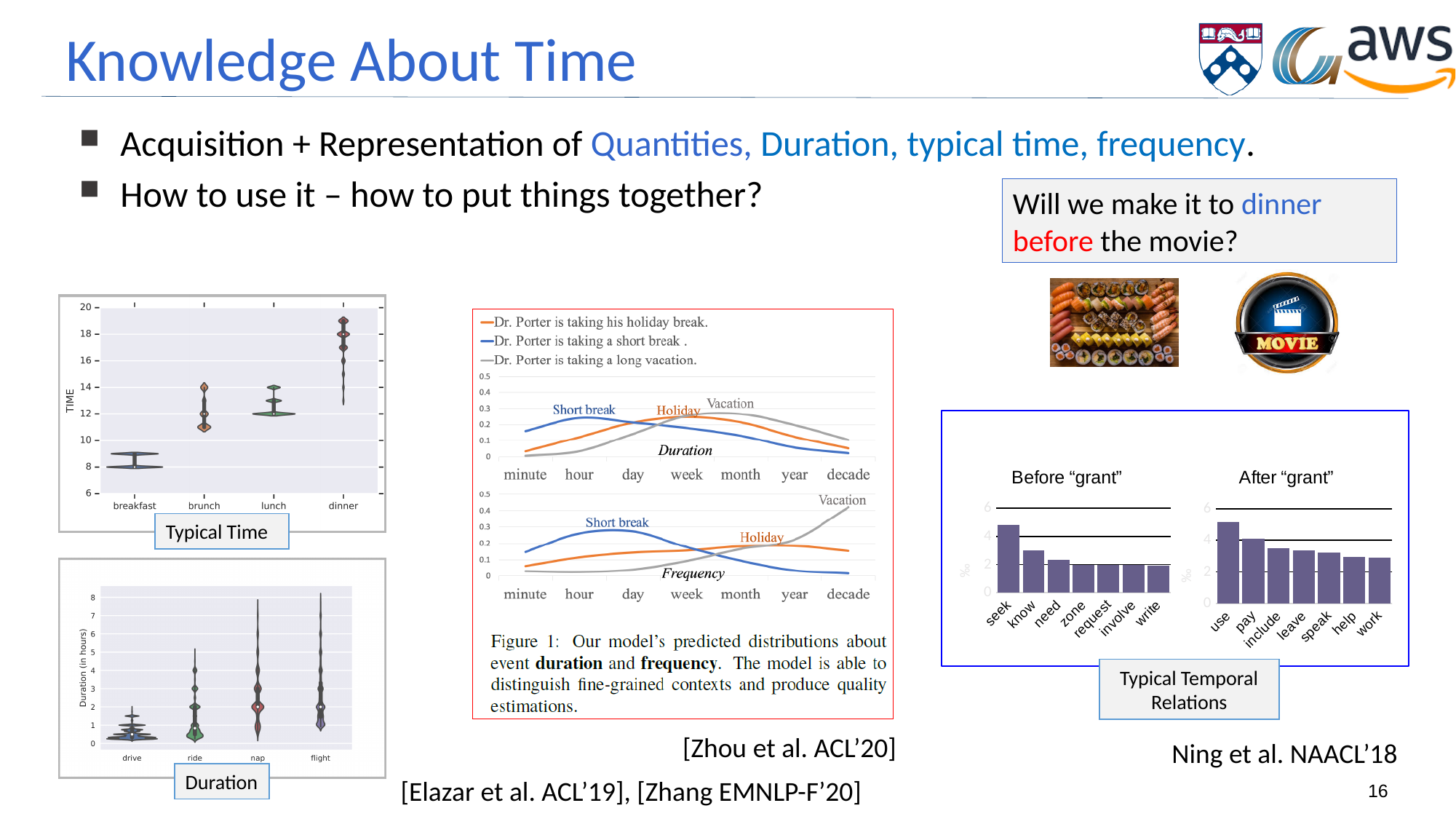
In the Frequency plot of the Zhou et al. figure, which series has the highest value at decade? Vacation How many meal categories are shown on the x axis of the Typical Time chart? 4 In the Typical Time chart, is the value for breakfast greater or less than 10? less In the Typical Time chart, which meal has the highest typical time? dinner What kind of chart is the After "grant" chart? bar chart In the Zhou et al. figure, how many series does the legend list? 3 In the Zhou et al. figure, how many time units are shown on the x axis of the Duration plot? 7 In the After "grant" chart, is the value for use greater or less than 4? greater How many activity categories are shown on the x axis of the Duration chart? 4 In the Duration chart, which activity has the shortest duration? drive In the Typical Time chart, which meal has the lowest typical time? breakfast In the Before "grant" chart, which word has the highest bar? seek